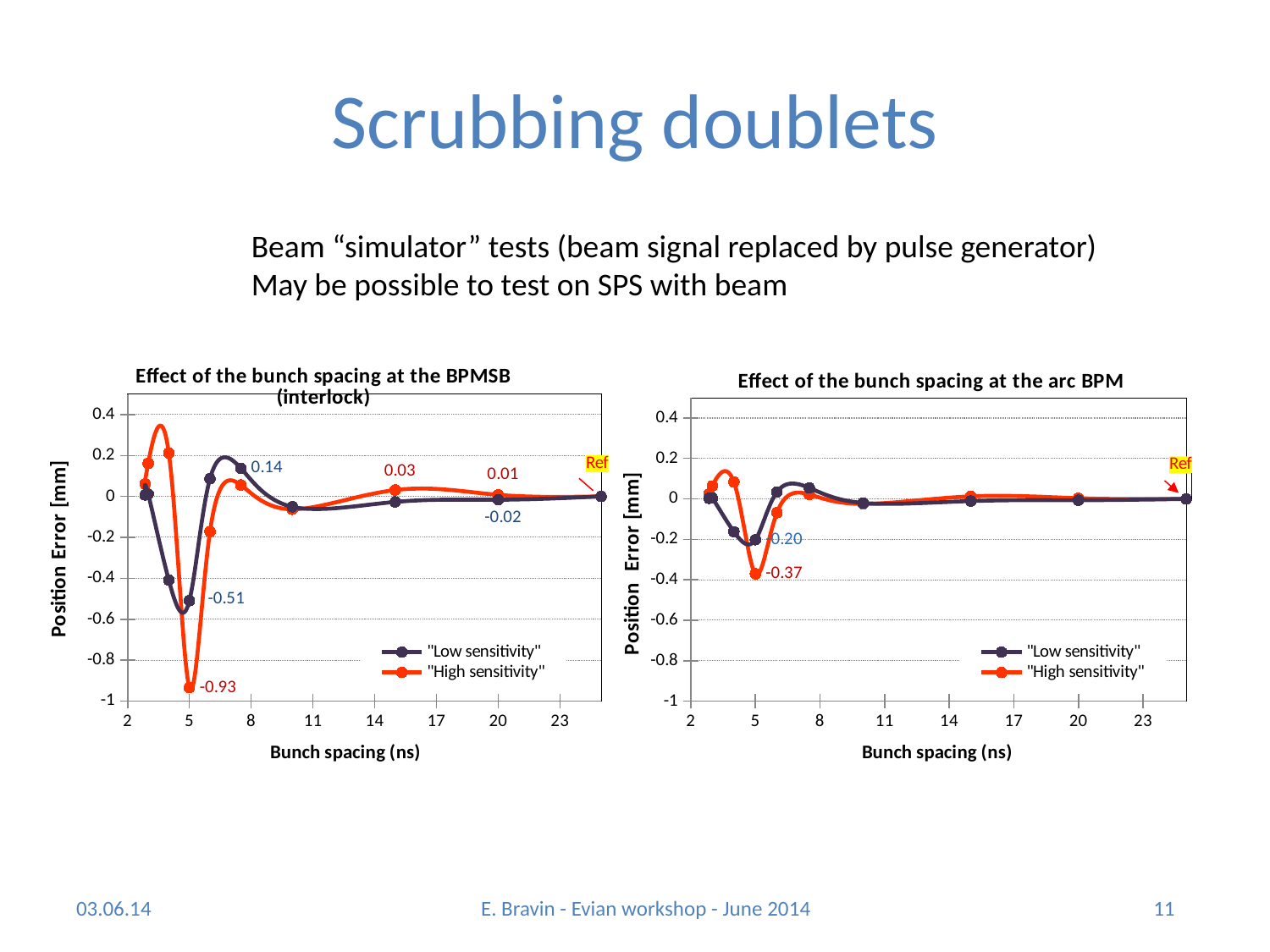
In the left chart (BPMSB interlock), is the 'Low sensitivity' value at 4 ns bunch spacing greater or less than -0.2? less How many series does the legend of the right chart, 'Effect of the bunch spacing at the arc BPM', list? 2 In the right chart (arc BPM), which series reaches the lower minimum, 'Low sensitivity' or 'High sensitivity'? High sensitivity What kind of chart is the left chart, 'Effect of the bunch spacing at the BPMSB (interlock)'? line chart In the left chart (BPMSB interlock), what is the labelled value of the 'Low sensitivity' series at 20 ns bunch spacing? -0.02 In the left chart (BPMSB interlock), what is the labelled value of the 'High sensitivity' series at 20 ns bunch spacing? 0.01 In the right chart (arc BPM), what is the labelled minimum value of the 'Low sensitivity' series? -0.20 In the right chart (arc BPM), what is the labelled minimum value of the 'High sensitivity' series? -0.37 In the left chart (BPMSB interlock), what is the labelled minimum value of the 'High sensitivity' series? -0.93 In the left chart (BPMSB interlock), what is the labelled minimum value of the 'Low sensitivity' series? -0.51 In the left chart (BPMSB interlock), what is the difference between the labelled minima of the 'Low sensitivity' (-0.51) and 'High sensitivity' (-0.93) series? 0.42 What is the x-axis title of the right chart (arc BPM)? Bunch spacing (ns)